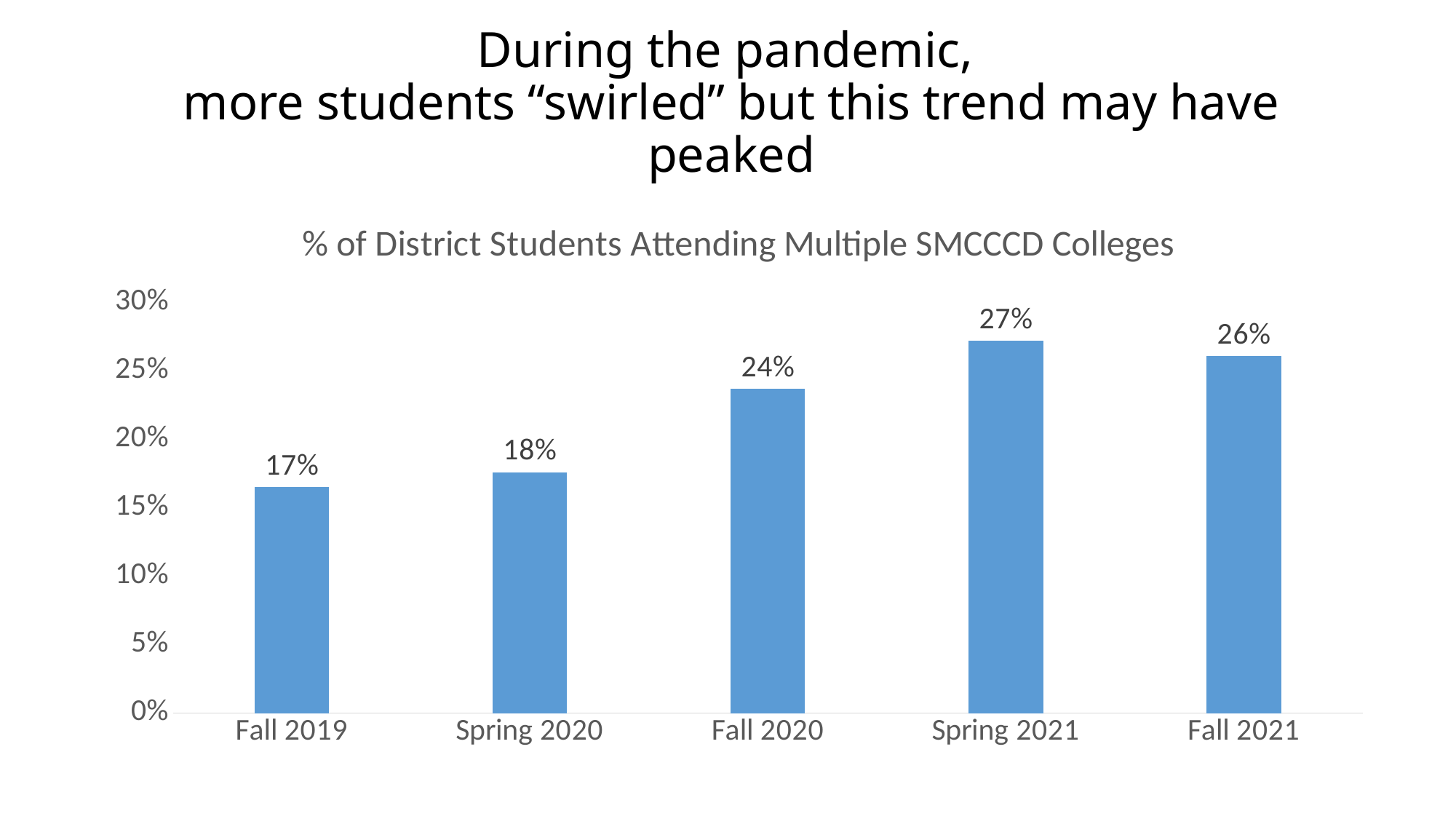
Which term has the lowest percentage of district students attending multiple SMCCCD colleges? Fall 2019 What is the difference between the values for Spring 2021 and Fall 2019? 10% What is the difference between the values for Fall 2020 and Spring 2020? 6% What is the value for Spring 2021? 27% What kind of chart is shown on the slide? Bar chart What is the value for Fall 2021? 26% How many terms are shown on the x axis? 5 Which is larger, the value for Fall 2020 or the value for Fall 2021? Fall 2021 Is the value for Fall 2020 greater or less than 20%? greater Which term has the highest percentage of district students attending multiple SMCCCD colleges? Spring 2021 What is the value for Fall 2019? 17% What is the title of the chart? % of District Students Attending Multiple SMCCCD Colleges